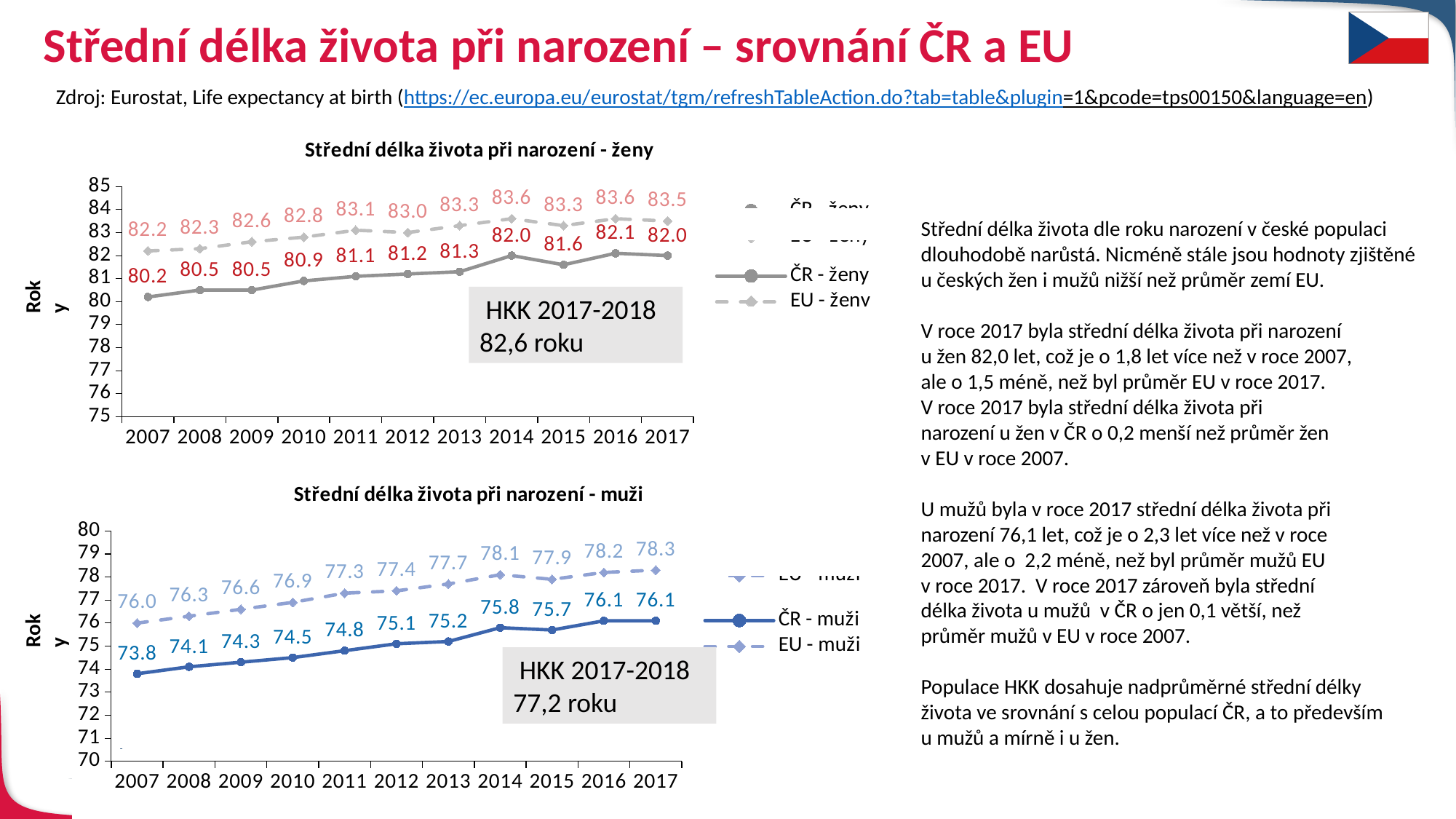
In the chart 'Střední délka života při narození - ženy', what is the difference between EU - ženy and ČR - ženy in 2017? 1.5 In the chart 'Střední délka života při narození - muži', what is the difference between the ČR - muži values in 2017 and 2007? 2.3 In the chart 'Střední délka života při narození - ženy', what is the value for EU - ženy in 2014? 83.6 In the chart 'Střední délka života při narození - muži', in which year is the EU - muži value highest? 2017 In the chart 'Střední délka života při narození - muži', what is the value for ČR - muži in 2007? 73.8 In the chart 'Střední délka života při narození - ženy', what is the value for ČR - ženy in 2017? 82.0 In the chart 'Střední délka života při narození - ženy', in which year is the ČR - ženy value lowest? 2007 In the chart 'Střední délka života při narození - muži', does the ČR - muži series generally rise or fall from 2007 to 2017? Rise How many years are shown on the x axis of the chart 'Střední délka života při narození - ženy'? 11 In the chart 'Střední délka života při narození - muži', what is the value for EU - muži in 2017? 78.3 What type of chart is 'Střední délka života při narození - muži'? Line chart In the chart 'Střední délka života při narození - muži', which is larger in 2010: ČR - muži or EU - muži? EU - muži